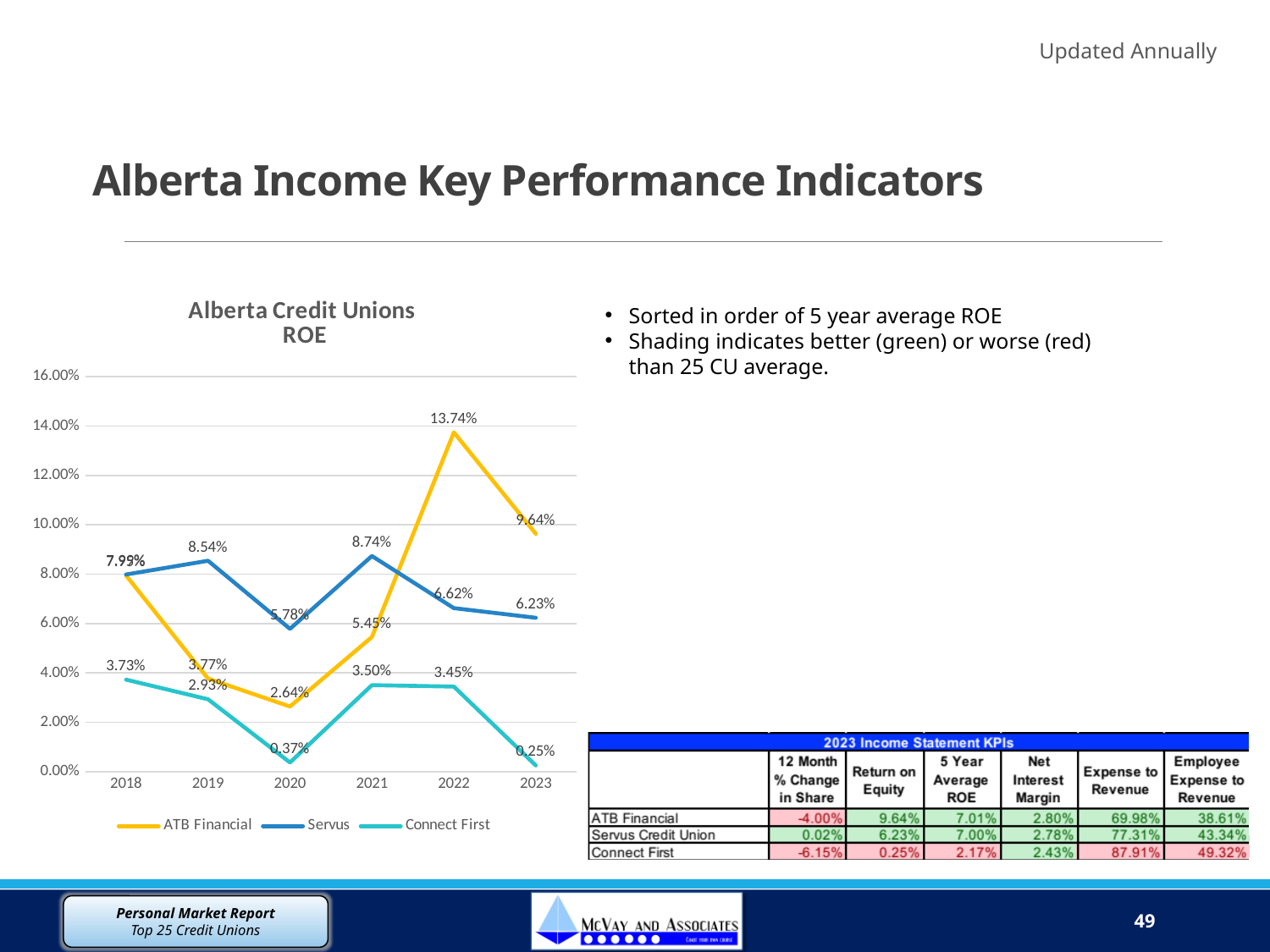
Is the ROE for Servus in 2019 greater or less than 8.00%? greater In 2021, which has the higher ROE, Servus or ATB Financial? Servus How many series does the legend of the Alberta Credit Unions ROE chart list? 3 In which year is the ROE for Connect First lowest? 2023 Does the ROE for Connect First rise or fall from 2022 to 2023? fall What is the difference between the 2023 ROE of ATB Financial and Servus? 3.41% What is the ROE for ATB Financial in 2022? 13.74% What is the ROE for Connect First in 2020? 0.37% In which year is the ROE for ATB Financial highest? 2022 What is the ROE for Servus in 2021? 8.74% What kind of chart is the Alberta Credit Unions ROE chart? line chart How many years are plotted on the x axis of the Alberta Credit Unions ROE chart? 6